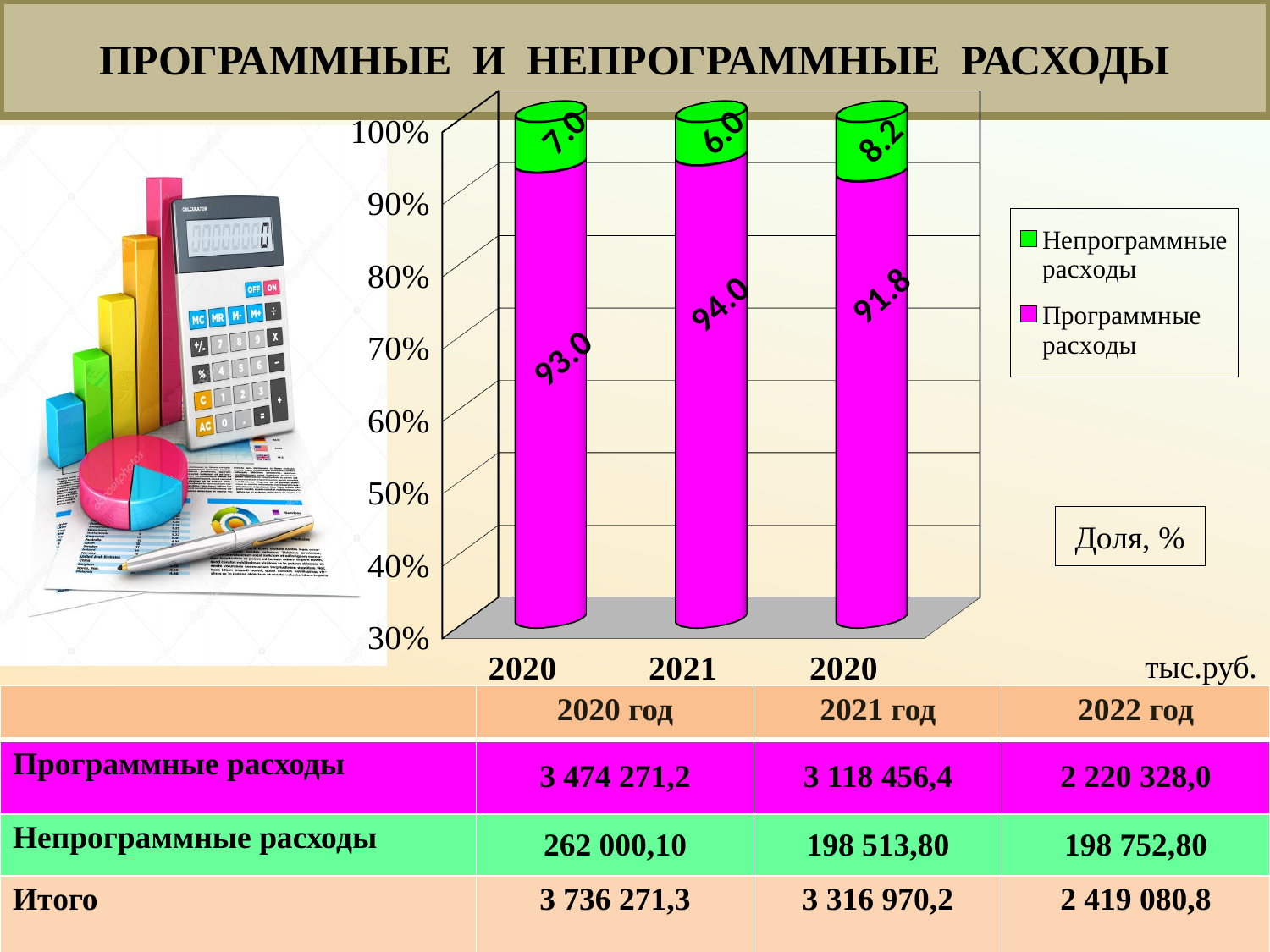
Which is larger: the Непрограммные расходы value for 2021 or for the leftmost bar (2020)? the leftmost bar (2020) Which year has the highest value for Программные расходы? 2021 Which year has the lowest value for Непрограммные расходы? 2021 Which bar has the highest value for Непрограммные расходы? the rightmost (third) bar How many bars are plotted in the chart? 3 What is the value of Программные расходы for the leftmost bar (2020)? 93.0 What is the difference between the Программные расходы value for 2021 and for the leftmost bar (2020)? 1.0 What is the value of Непрограммные расходы for 2021? 6.0 What type of chart is shown on the slide? stacked bar chart What is the value of Программные расходы for 2021? 94.0 What is the value of Непрограммные расходы for the rightmost (third) bar? 8.2 How many series does the legend list? 2